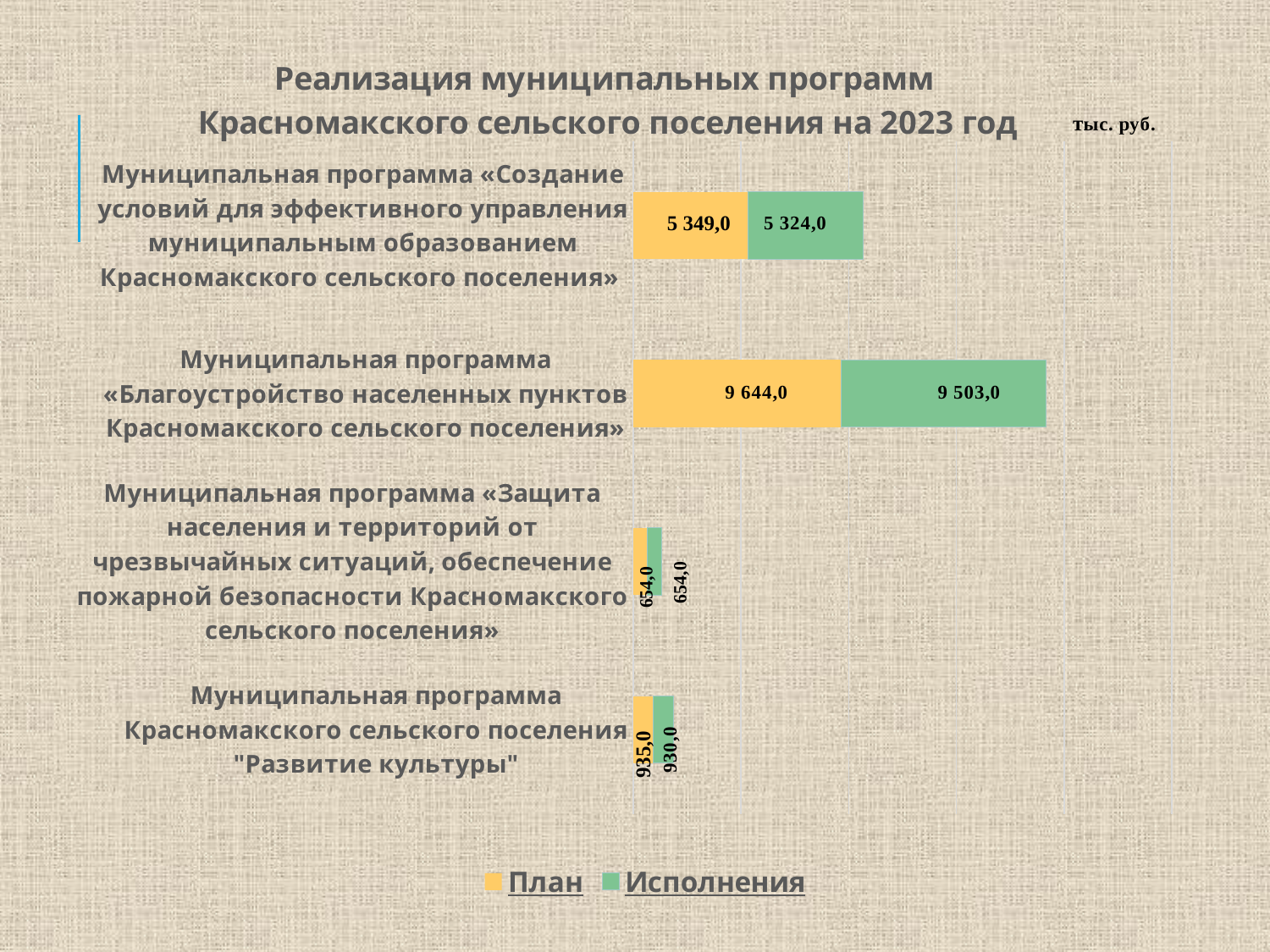
How many programmes (categories) are shown in the chart? 4 What is the difference between the План and Исполнения values for the programme "Развитие культуры"? 5,0 Which programme has the lowest Исполнения value? Муниципальная программа «Защита населения и территорий от чрезвычайных ситуаций, обеспечение пожарной безопасности Красномакского сельского поселения» What is the Исполнения value for the programme "Развитие культуры"? 930,0 What is the difference between the План and Исполнения values for the programme «Благоустройство населенных пунктов Красномакского сельского поселения»? 141,0 Which is larger: the План value for "Развитие культуры" or the План value for the programme «Защита населения и территорий от чрезвычайных ситуаций...»? "Развитие культуры" Which programme has the highest План value? Муниципальная программа «Благоустройство населенных пунктов Красномакского сельского поселения» What kind of chart is shown on the slide? Bar chart What is the Исполнения value for the programme «Создание условий для эффективного управления муниципальным образованием Красномакского сельского поселения»? 5 324,0 What is the total of the stacked bar for the programme «Благоустройство населенных пунктов Красномакского сельского поселения»? 19 147,0 How many series does the legend list? 2 What is the План value for the programme «Благоустройство населенных пунктов Красномакского сельского поселения»? 9 644,0